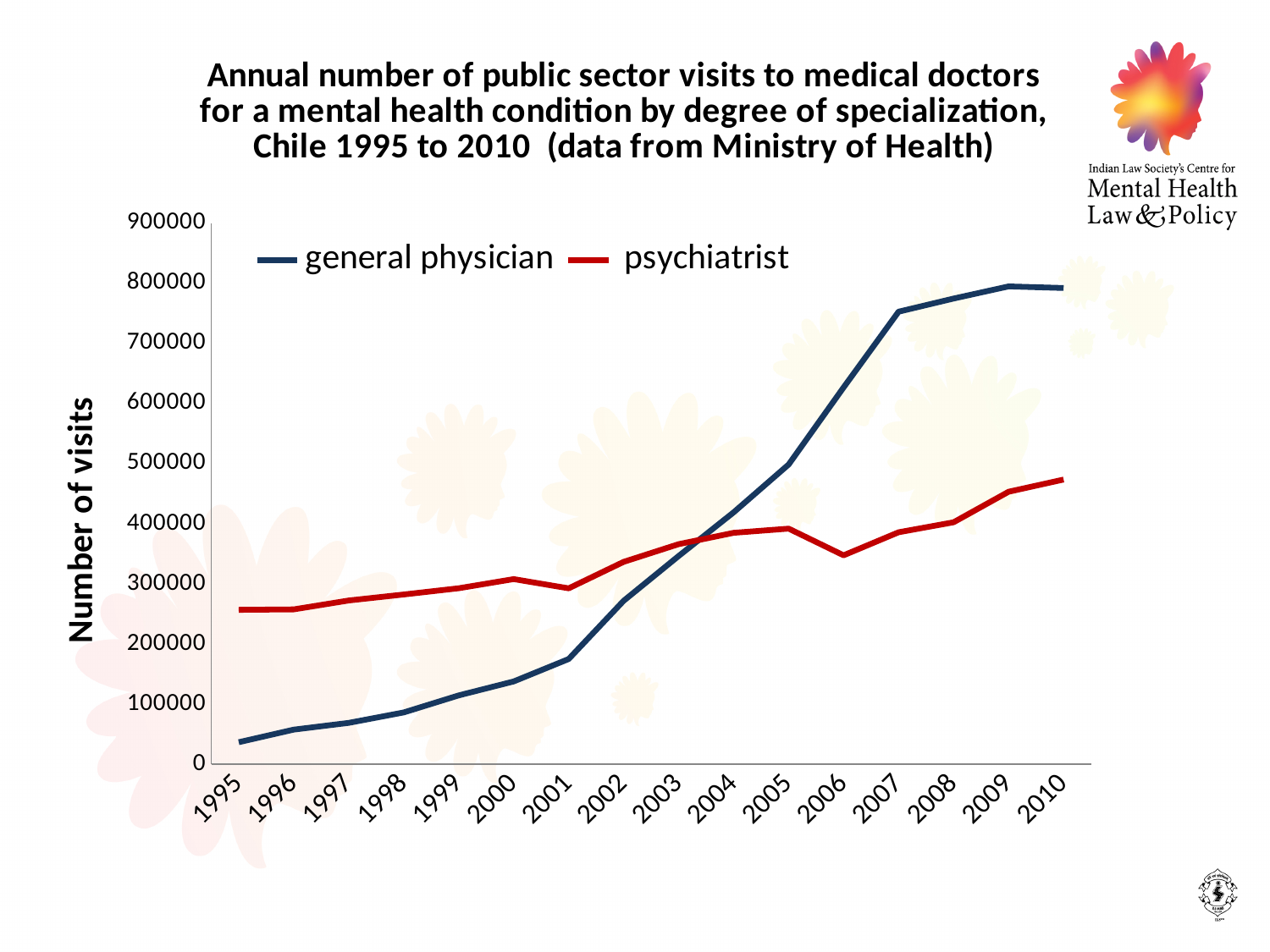
Is the value for general physician in 2010 greater or less than 700000? greater What is the label of the y axis? Number of visits Which series is drawn in red? psychiatrist How many series does the legend list? 2 What kind of chart is shown on the slide? line chart Is the value for general physician in 1995 greater or less than 100000? less Do the values for general physician rise or fall from 1995 to 2010? rise Is the value for psychiatrist in 1995 greater or less than 200000? greater How many years are plotted along the x axis? 16 In 2010, which series has the larger value, general physician or psychiatrist? general physician In 1995, which series has the larger value, general physician or psychiatrist? psychiatrist